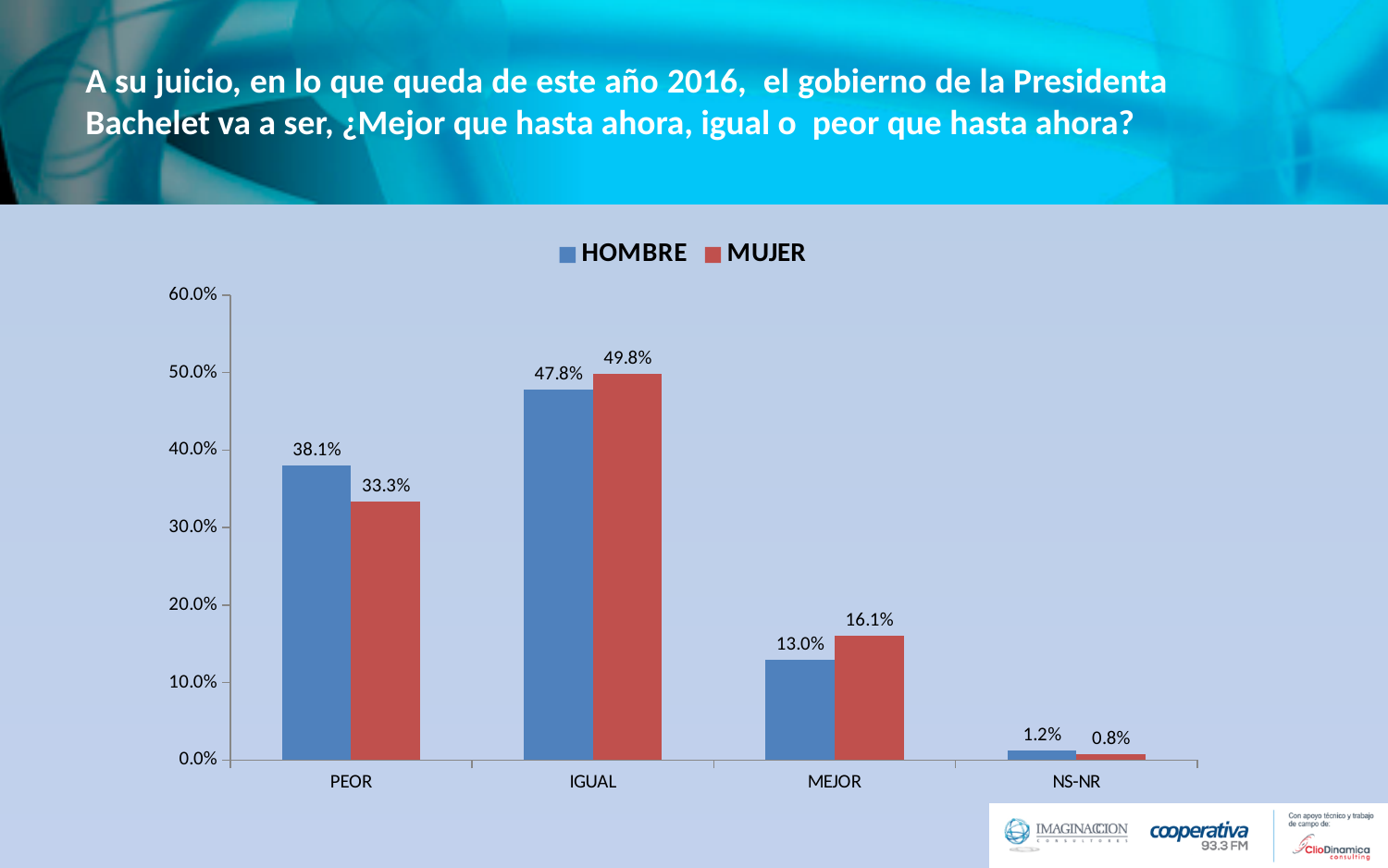
Is the value for MUJER in the IGUAL category greater or less than 40.0%? greater What is the value for MUJER in the IGUAL category? 49.8% Which category has the highest value for HOMBRE? IGUAL What is the value for HOMBRE in the NS-NR category? 1.2% What is the value for HOMBRE in the PEOR category? 38.1% What is the value for MUJER in the MEJOR category? 16.1% How many series does the legend list? 2 Which category has the lowest value for MUJER? NS-NR In the MEJOR category, which series has the larger value, HOMBRE or MUJER? MUJER How many categories are shown on the x axis? 4 What is the difference between the HOMBRE and MUJER values in the PEOR category? 4.8% What kind of chart is shown on the slide? bar chart